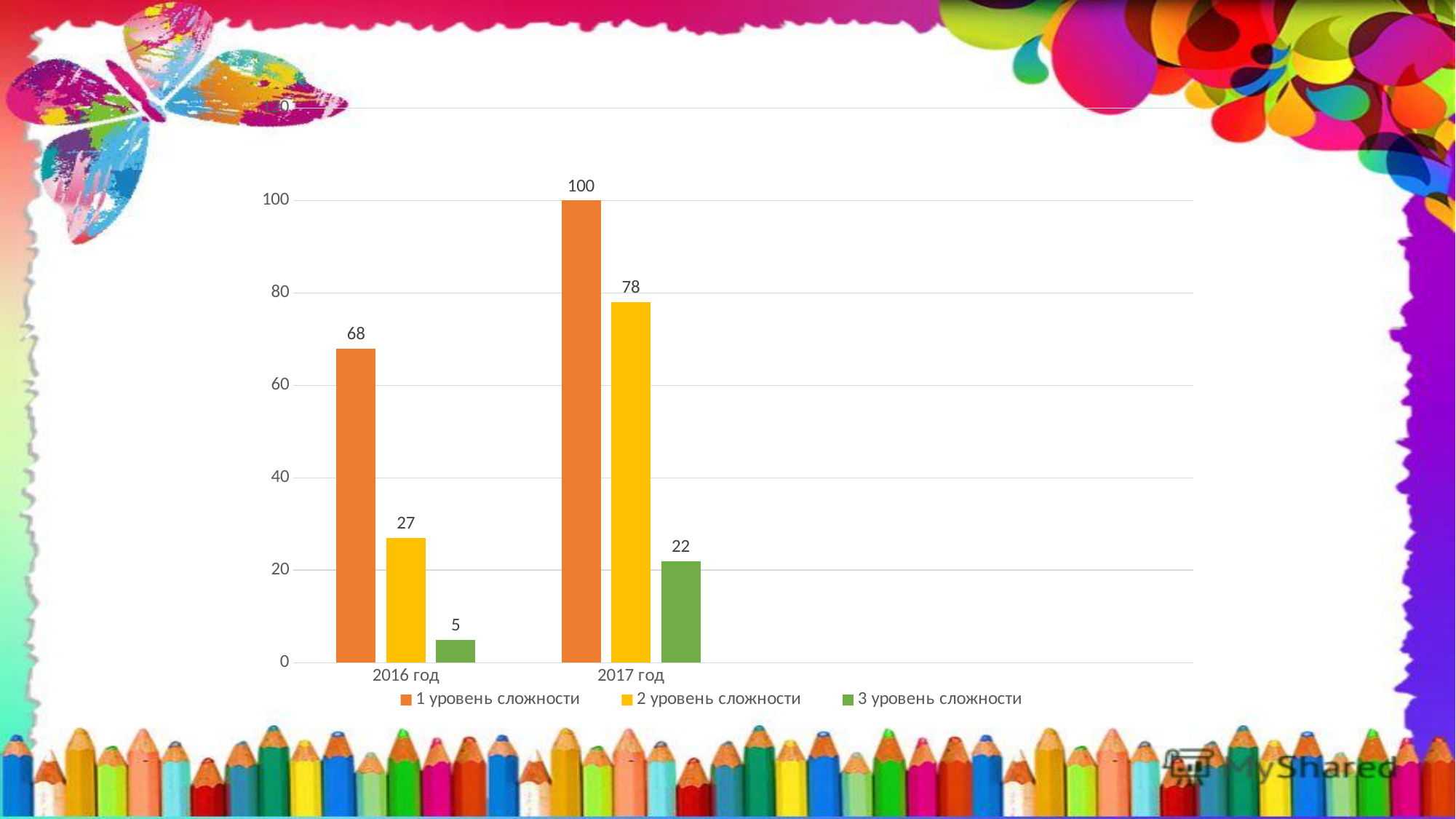
How many series does the legend list? 3 Which series has the highest value in 2017 год? 1 уровень сложности What is the value for 2 уровень сложности in 2017 год? 78 What is the value for 3 уровень сложности in 2017 год? 22 What kind of chart is shown on the slide? Bar chart What is the value for 3 уровень сложности in 2016 год? 5 Which series has the lowest value in 2016 год? 3 уровень сложности How many categories are shown on the x axis? 2 What is the difference between the 1 уровень сложности values for 2017 год and 2016 год? 32 Which is larger: 2 уровень сложности in 2016 год or 3 уровень сложности in 2017 год? 2 уровень сложности in 2016 год Does the value for 2 уровень сложности rise or fall from 2016 год to 2017 год? Rise What is the value for 1 уровень сложности in 2016 год? 68